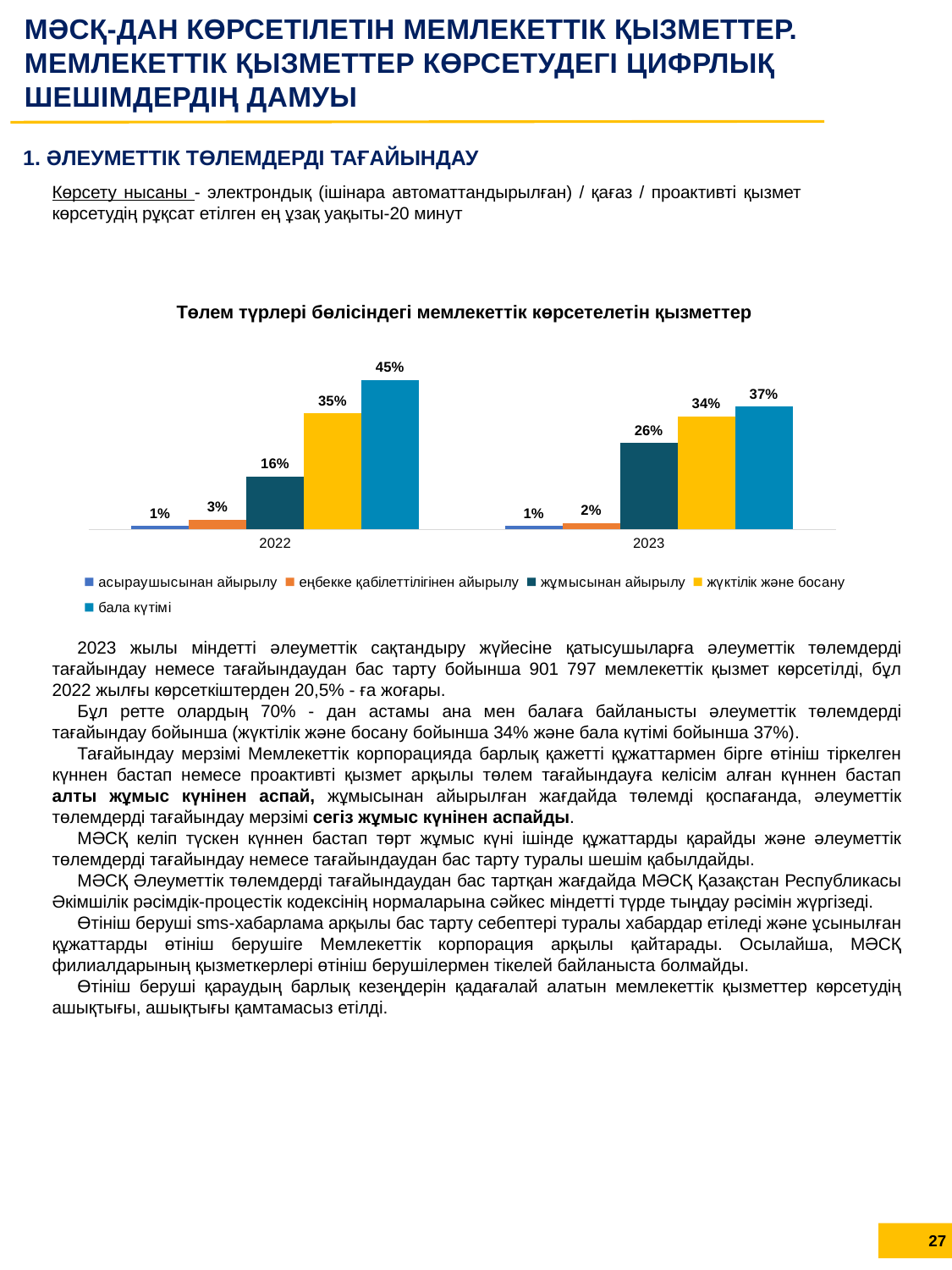
Which series has the highest value in 2022? бала күтімі Which series has the lowest value in 2023? асыраушысынан айырылу What is the value for еңбекке қабілеттілігінен айырылу in 2022? 3% What is the title of the chart? Төлем түрлері бөлісіндегі мемлекеттік көрсетелетін қызметтер Which is larger: жұмысынан айырылу in 2022 or жұмысынан айырылу in 2023? 2023 What is the value for жүктілік және босану in 2023? 34% What is the value for бала күтімі in 2022? 45% How many series does the chart legend list? 5 What is the difference between the бала күтімі values for 2022 and 2023? 8% What type of chart is shown on the slide? bar chart What is the value for жұмысынан айырылу in 2023? 26% How many year categories are shown on the x axis of the chart? 2